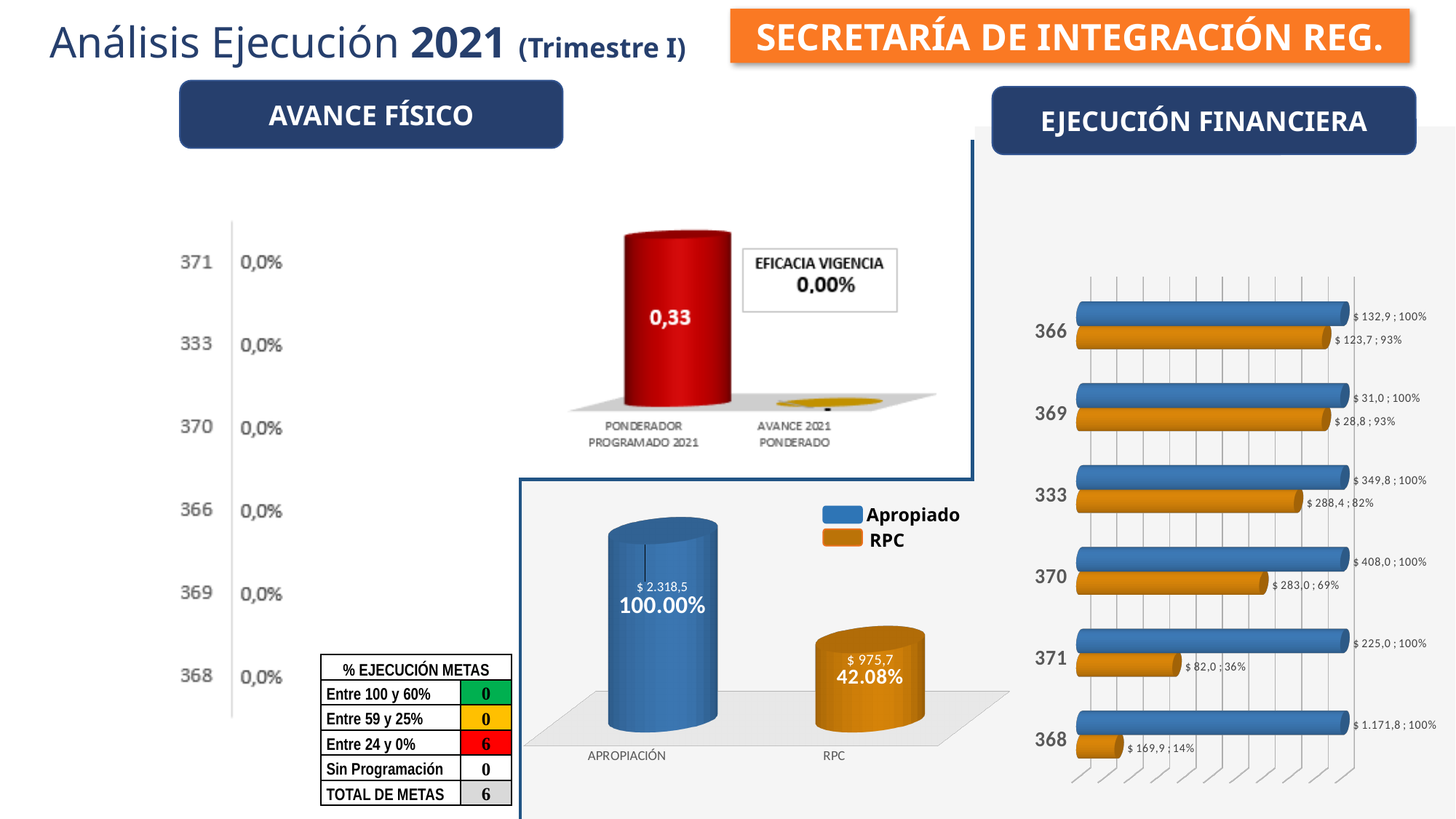
In the cylinder chart with APROPIACIÓN and RPC, what is the value for RPC? $ 975,7 In the horizontal bar chart on the right, what is the RPC value for project 370? $ 283,0 In the horizontal bar chart on the right, which project has the highest Apropiado value? 368 In the red cylinder chart, what is the value for PONDERADOR PROGRAMADO 2021? 0,33 In the horizontal bar chart on the right, what is the Apropiado value for project 368? $ 1.171,8 In the horizontal bar chart on the right, what is the difference between the Apropiado and RPC values for project 366? $ 9,2 In the horizontal bar chart on the right, what percentage is shown next to the RPC bar for project 371? 36% In the horizontal bar chart on the right, which project has the lowest RPC percentage? 368 In the horizontal bar chart on the right, how many projects are shown? 6 In the horizontal bar chart on the right, how many series does the legend list? 2 In the cylinder chart with APROPIACIÓN and RPC, what percentage is shown for APROPIACIÓN? 100.00% In the AVANCE FÍSICO chart on the left, what value is shown for project 333? 0,0%